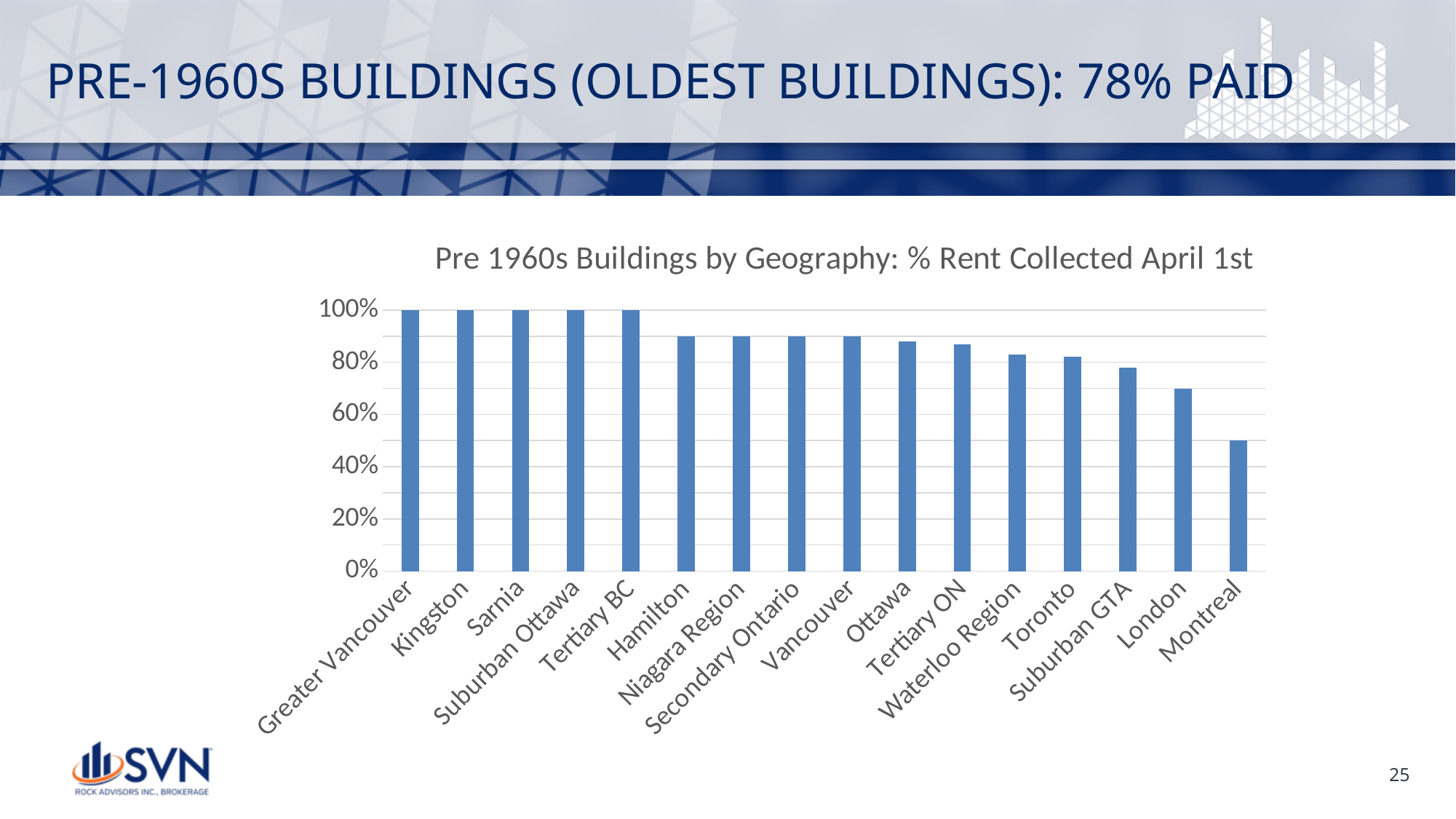
What is the % rent collected for Tertiary BC? 100% Which has a higher % rent collected, Toronto or London? Toronto How many geographies are plotted in the chart? 16 Is the value for Montreal greater or less than 60%? less What is the % rent collected for Greater Vancouver? 100% Is the value for London greater or less than 80%? less Is the value for Hamilton greater or less than 80%? greater Which has a higher % rent collected, Kingston or Montreal? Kingston What type of chart is shown on the slide? Bar chart Do the values rise or fall moving from left to right along the x axis? Fall What is the title of the chart? Pre 1960s Buildings by Geography: % Rent Collected April 1st Which geography has the lowest % rent collected? Montreal